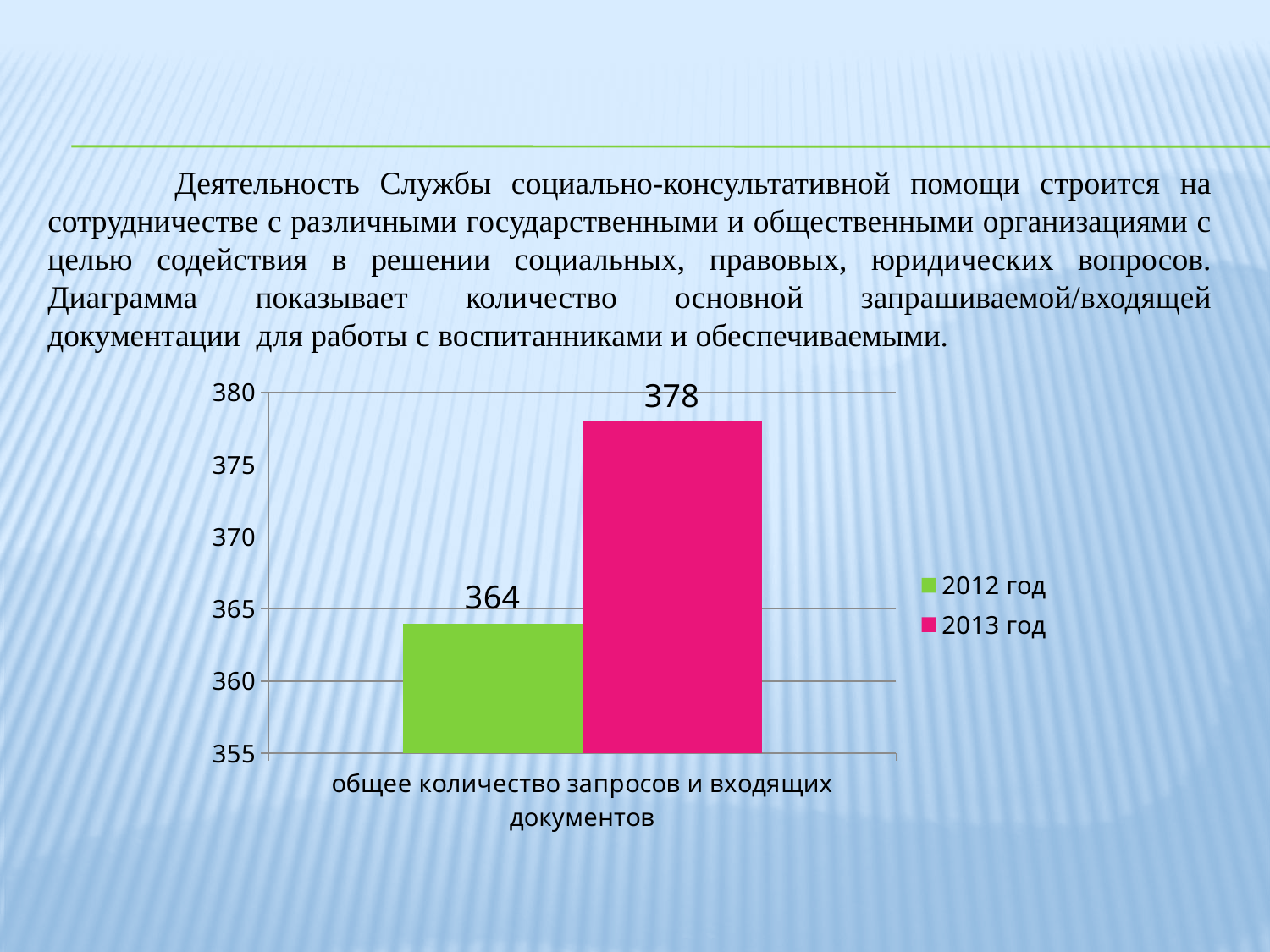
Which series has the lower value? 2012 год How many categories are shown on the x axis? 1 Is the value for 2012 год greater or less than 365? less What kind of chart is shown on the slide? bar chart What is the category label on the x axis? общее количество запросов и входящих документов What is the value for 2013 год? 378 Which series has the higher value, 2012 год or 2013 год? 2013 год How many series does the legend list? 2 What is the difference between the 2013 год and 2012 год values? 14 What is the value for 2012 год? 364 Is the value for 2013 год greater or less than 375? greater What colour is the bar for 2013 год? pink